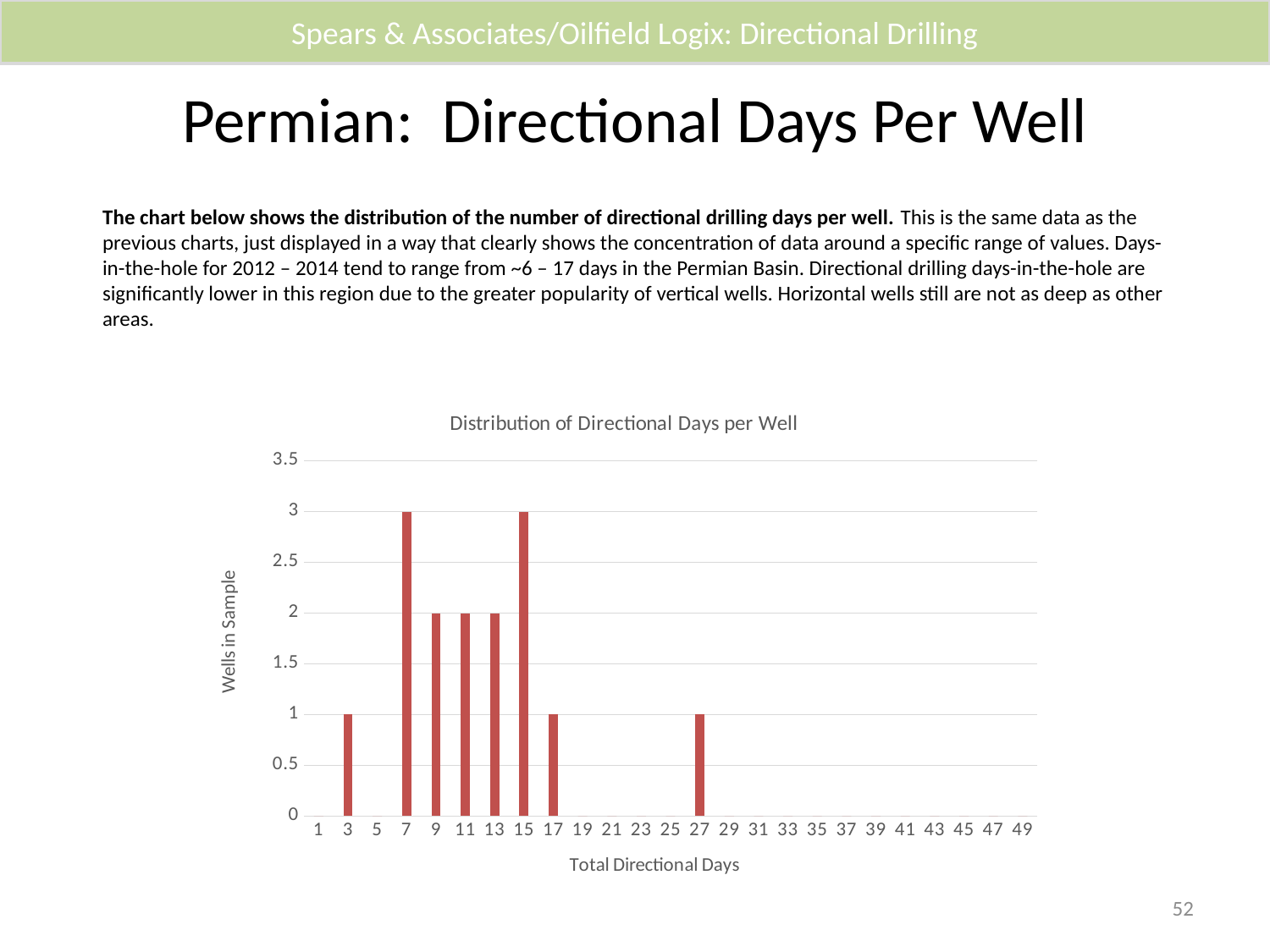
How many bars are plotted in the chart? 8 What is the label of the vertical axis? Wells in Sample How many wells in the sample have 27 total directional days? 1 What kind of chart is shown on the slide? bar chart Is the value for 27 total directional days greater or less than 2? less How many wells in the sample have 7 total directional days? 3 How many wells in the sample have 15 total directional days? 3 How many wells in the sample have 9 total directional days? 2 What is the difference between the number of wells with 7 total directional days and the number with 17 total directional days? 2 Which has more wells in the sample: 7 total directional days or 9 total directional days? 7 total directional days What is the title of the chart? Distribution of Directional Days per Well What is the highest number of wells shown for any value of total directional days? 3